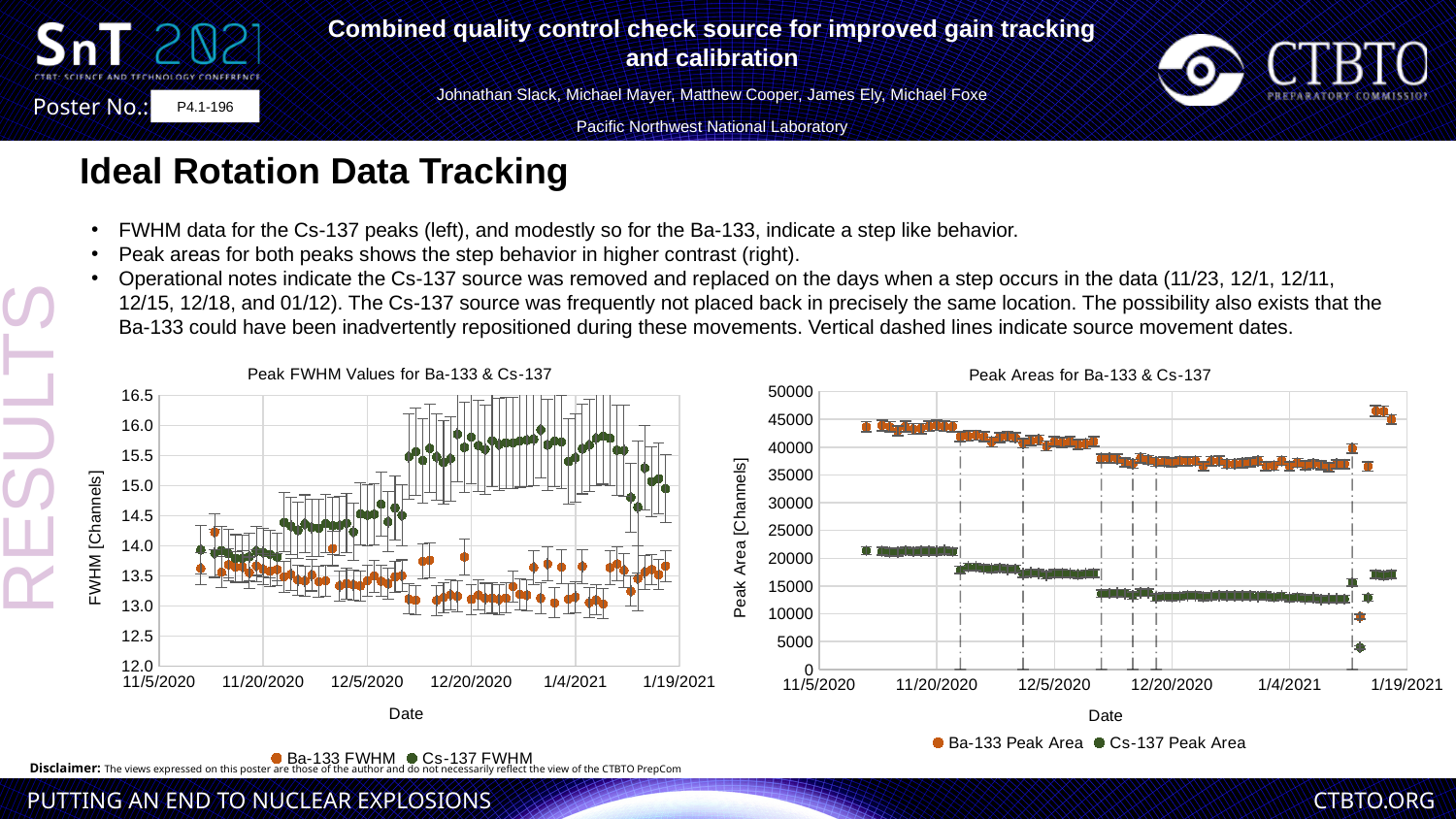
What is the title of the chart on the left of the slide? Peak FWHM Values for Ba-133 & Cs-137 In the 'Peak Areas for Ba-133 & Cs-137' chart, is the Ba-133 Peak Area around 1/4/2021 greater or less than 35000? greater In the chart titled 'Peak Areas for Ba-133 & Cs-137', how many series does the legend list? 2 In the 'Peak Areas for Ba-133 & Cs-137' chart, is the Cs-137 Peak Area around 1/4/2021 greater or less than 15000? less What kind of chart is the 'Peak FWHM Values for Ba-133 & Cs-137' chart? Scatter chart What is the y-axis label of the 'Peak Areas for Ba-133 & Cs-137' chart? Peak Area [Channels] In the 'Peak Areas for Ba-133 & Cs-137' chart, which series has the larger peak area around 12/5/2020, Ba-133 or Cs-137? Ba-133 Peak Area In the 'Peak Areas for Ba-133 & Cs-137' chart, is the Cs-137 Peak Area around 11/10/2020 greater or less than 25000? less In the 'Peak FWHM Values for Ba-133 & Cs-137' chart, does the Cs-137 FWHM generally rise or fall from November 2020 to January 2021? rise